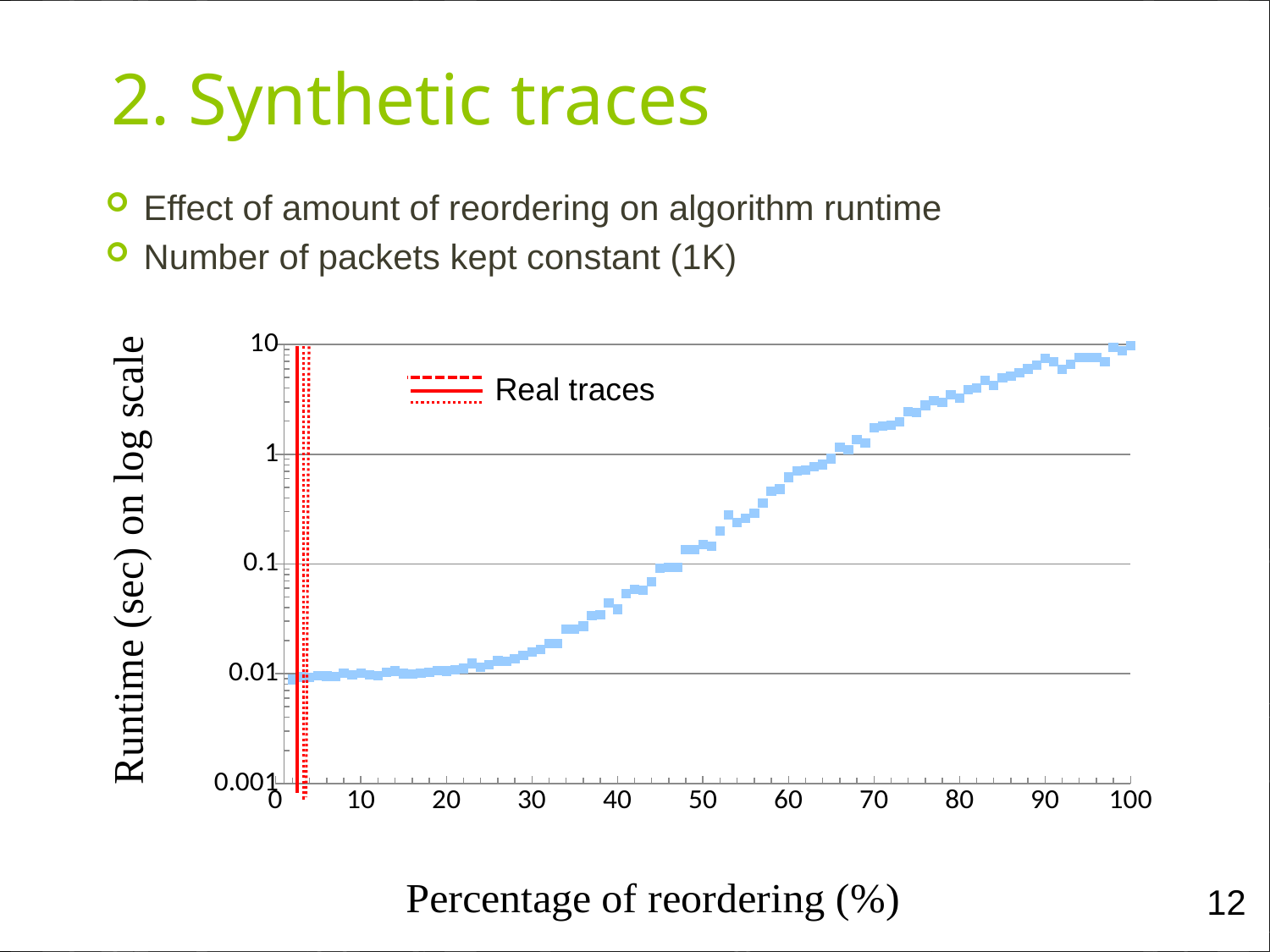
Do the runtime values rise or fall as the percentage of reordering increases along the x axis? rise Is the runtime at 20% reordering greater or less than 0.1 seconds? less What does the legend entry with the red vertical lines represent? Real traces Is the runtime at 30% reordering greater or less than 0.1 seconds? less Is the runtime at 10% reordering greater or less than 0.1 seconds? less What kind of chart is shown on the slide? scatter chart What is the label of the y axis? Runtime (sec) on log scale Which has the larger runtime: 40% reordering or 90% reordering? 90% reordering